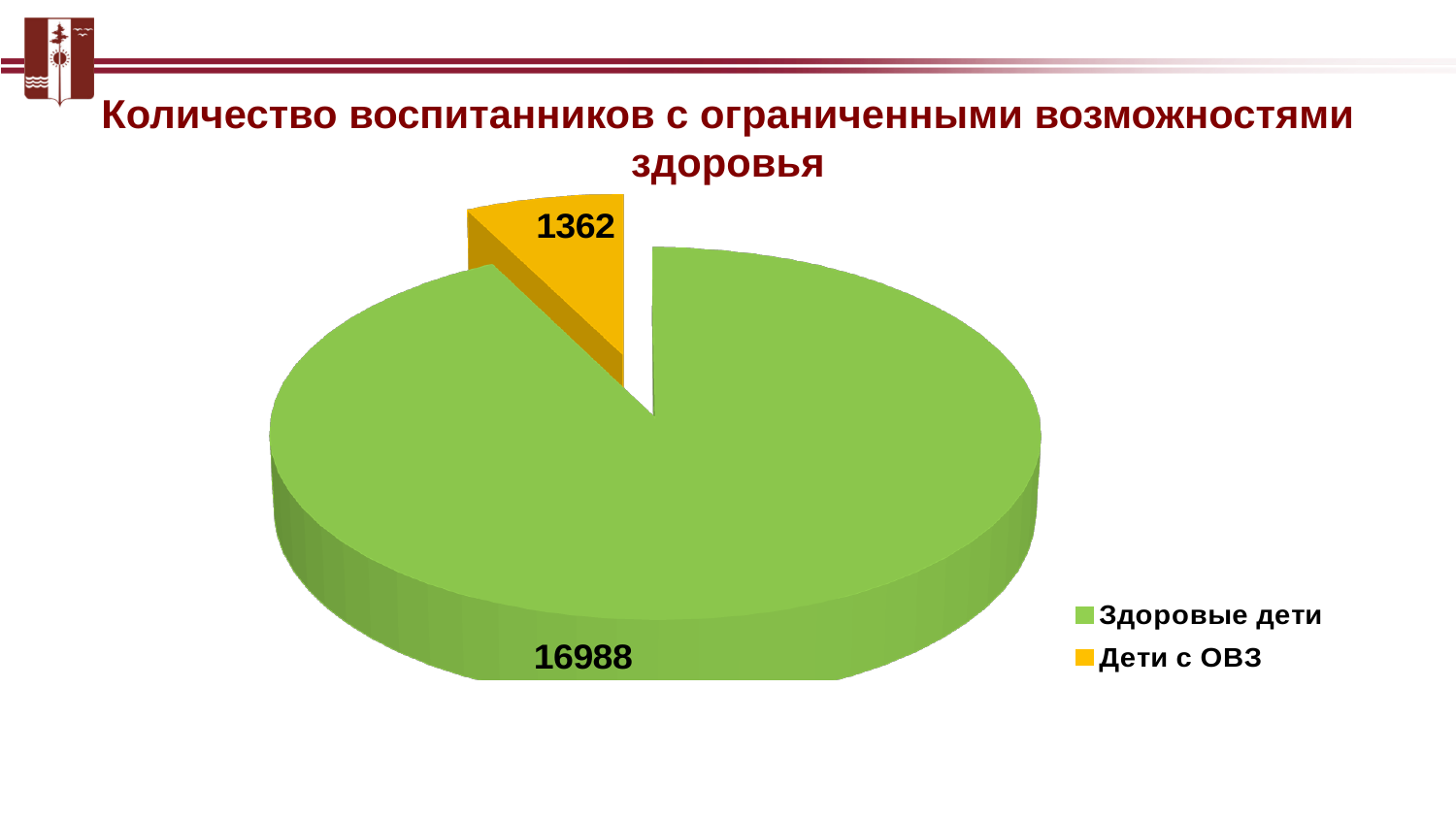
What colour is the slice for "Дети с ОВЗ"? Yellow What is the total of all slices in the pie chart? 18350 What is the value for "Здоровые дети"? 16988 What is the difference between the values for "Здоровые дети" and "Дети с ОВЗ"? 15626 How many slices does the pie chart have? 2 What share of the pie does "Дети с ОВЗ" represent, to the nearest whole percent? 7% Which is larger: the value for "Здоровые дети" or the value for "Дети с ОВЗ"? Здоровые дети What is the value for "Дети с ОВЗ"? 1362 What kind of chart is shown on the slide? Pie chart How many entries does the legend list? 2 Which category has the smallest slice of the pie? Дети с ОВЗ Which category has the largest slice of the pie? Здоровые дети